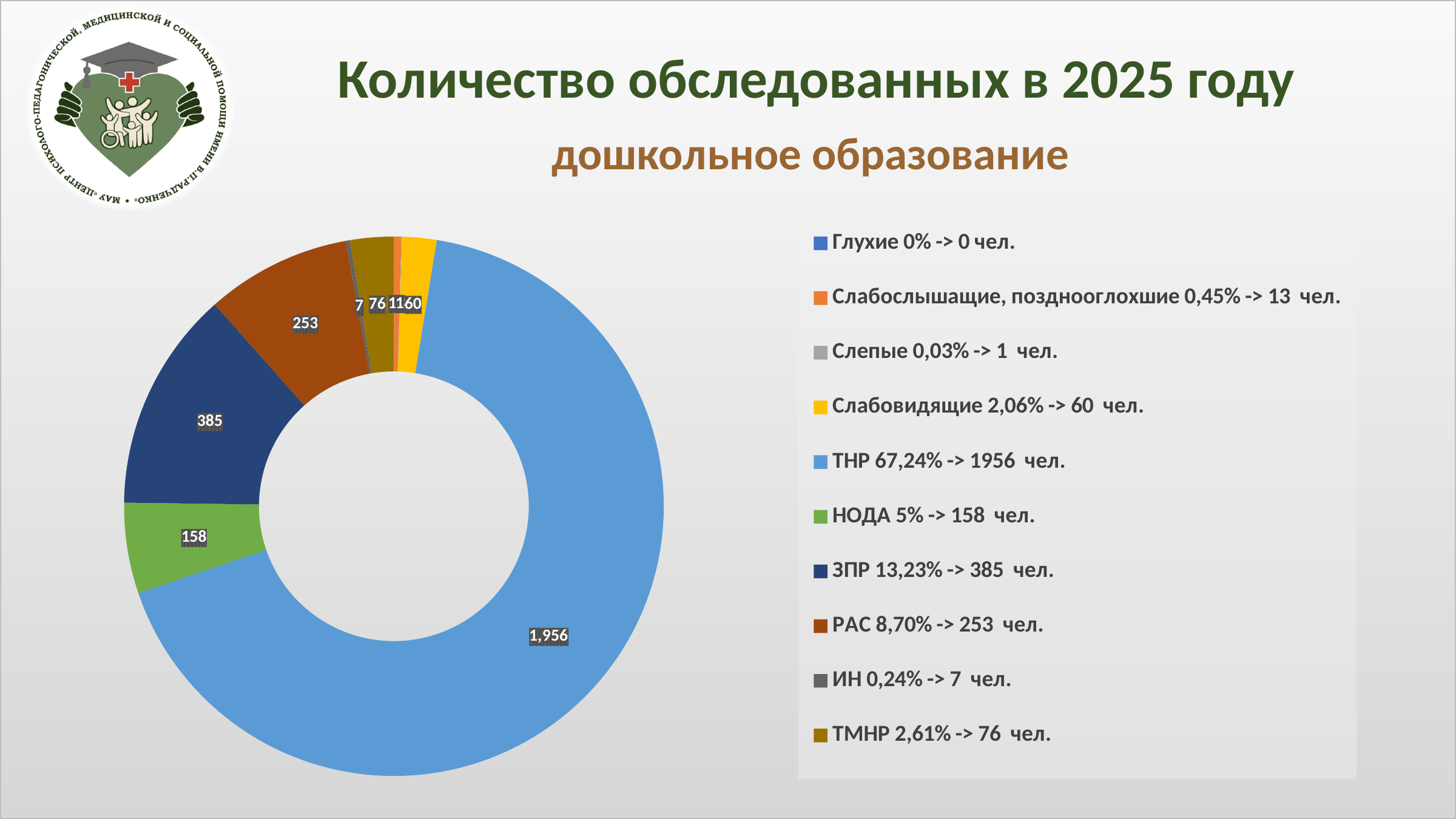
Which category has the largest value? ТНР What is the subtitle shown below the main title of the slide? дошкольное образование What is the difference between the values for ЗПР and РАС? 132 What kind of chart is shown on the slide? doughnut chart Which category has the smallest value? Глухие What is the difference between the values for ТНР and ЗПР? 1571 How many people are shown for ТНР? 1956 How many people are shown for Слабовидящие? 60 What share of the total does РАС represent? 8,70% What percentage is shown for ЗПР in the legend? 13,23% Which is larger, the value for НОДА or the value for ТМНР? НОДА How many categories does the legend list? 10